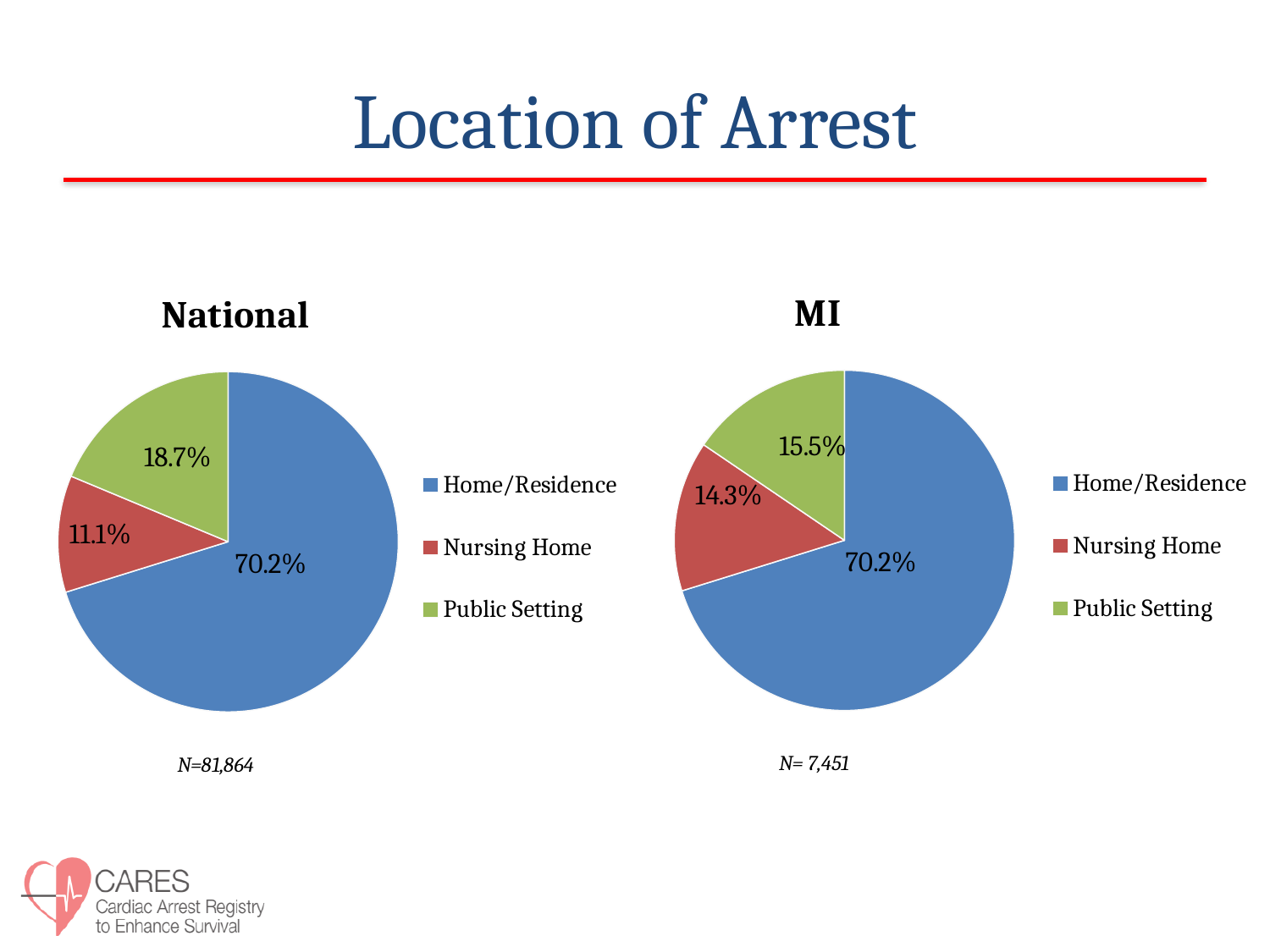
How many categories does the MI pie chart show? 3 In the MI pie chart, which location has the smallest share? Nursing Home In the National pie chart, what is the difference between the Public Setting share and the Nursing Home share? 7.6% In the MI pie chart, what percentage of arrests occurred in a Public Setting? 15.5% In the MI pie chart, what percentage of arrests occurred in a Nursing Home? 14.3% In the National pie chart, which location has the largest share? Home/Residence In the National pie chart, what percentage of arrests occurred in a Nursing Home? 11.1% What type of chart is used for the National data? Pie chart What is the N value shown below the MI pie chart? N= 7,451 In the National pie chart, which colour represents Public Setting? Green In the National pie chart, what percentage of arrests occurred at Home/Residence? 70.2% Which chart shows a larger Nursing Home share, National or MI? MI